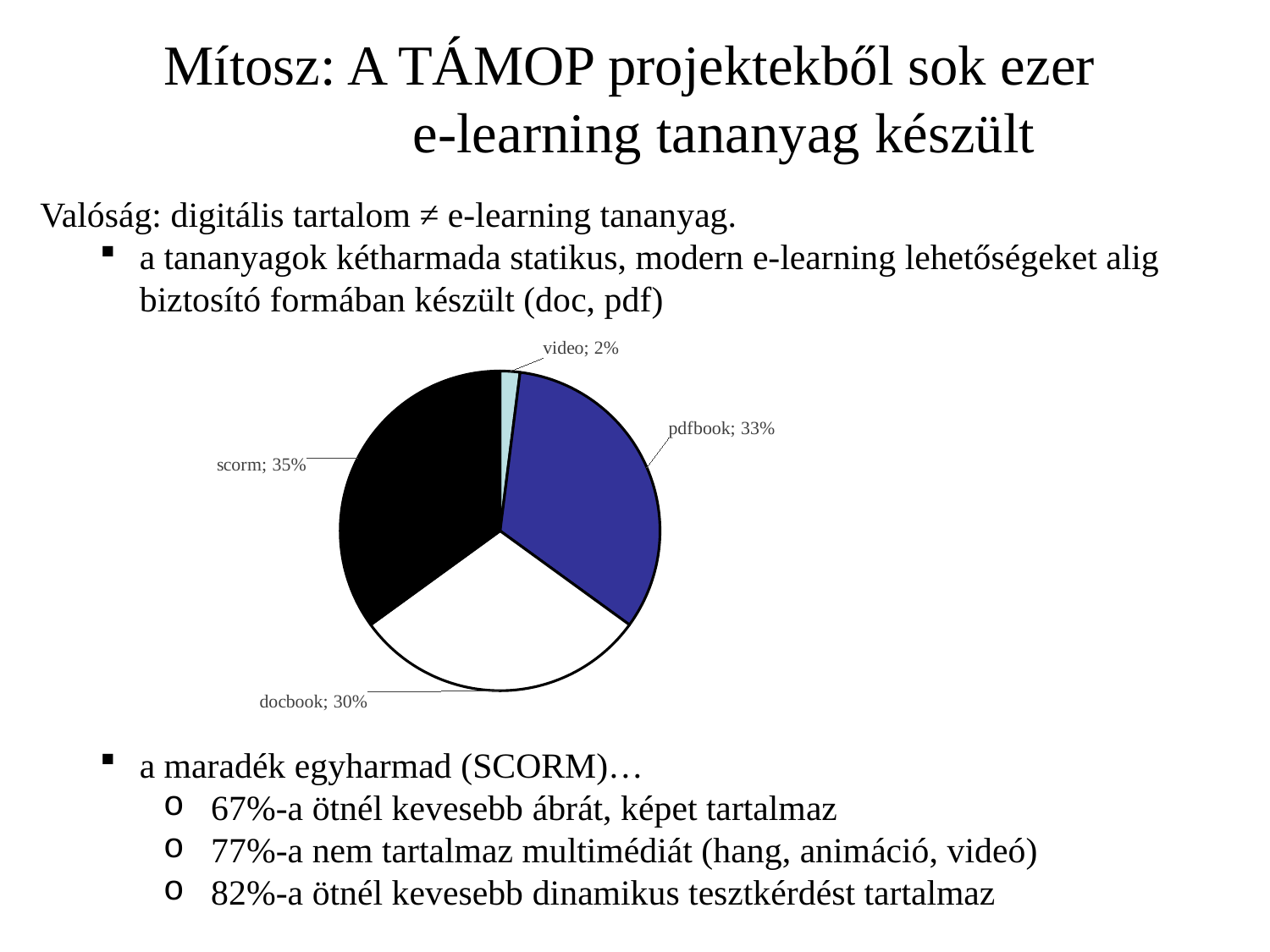
What is the difference in percentage points between the scorm and docbook slices? 5 What share of the pie does video have? 2% What colour is the scorm slice of the pie? black What kind of chart is shown on the slide? pie chart Which slice of the pie is the smallest? video What is the combined share of the pdfbook and docbook slices? 63% Which is larger, the pdfbook slice or the docbook slice? pdfbook Which slice of the pie is the largest? scorm What share of the pie does pdfbook have? 33% What share of the pie does scorm have? 35% How many slices does the pie chart have? 4 What share of the pie does docbook have? 30%